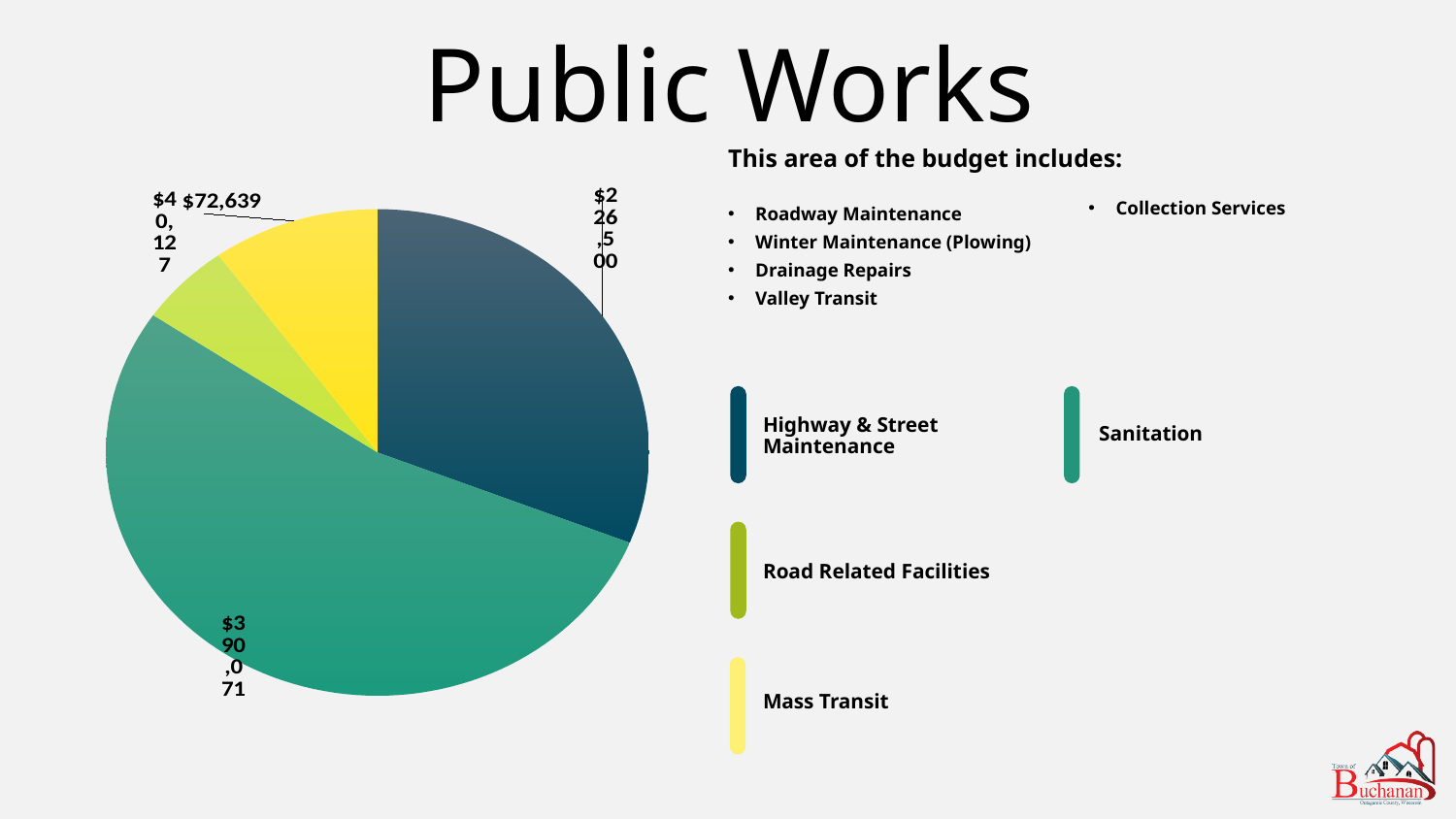
How much larger is Sanitation than Highway & Street Maintenance? $163,571 Which is larger, Highway & Street Maintenance or Mass Transit? Highway & Street Maintenance What is the value of the Mass Transit slice? $72,639 What is the value of the Sanitation slice in the pie chart? $390,071 What is the difference between Mass Transit and Road Related Facilities? $32,512 Which category is shown in yellow in the pie chart? Mass Transit Which category has the largest slice of the pie chart? Sanitation How many slices does the pie chart have? 4 What type of chart is shown on the slide? Pie chart Which category has the smallest slice of the pie chart? Road Related Facilities What is the value of the Road Related Facilities slice? $40,127 What is the value of the Highway & Street Maintenance slice? $226,500